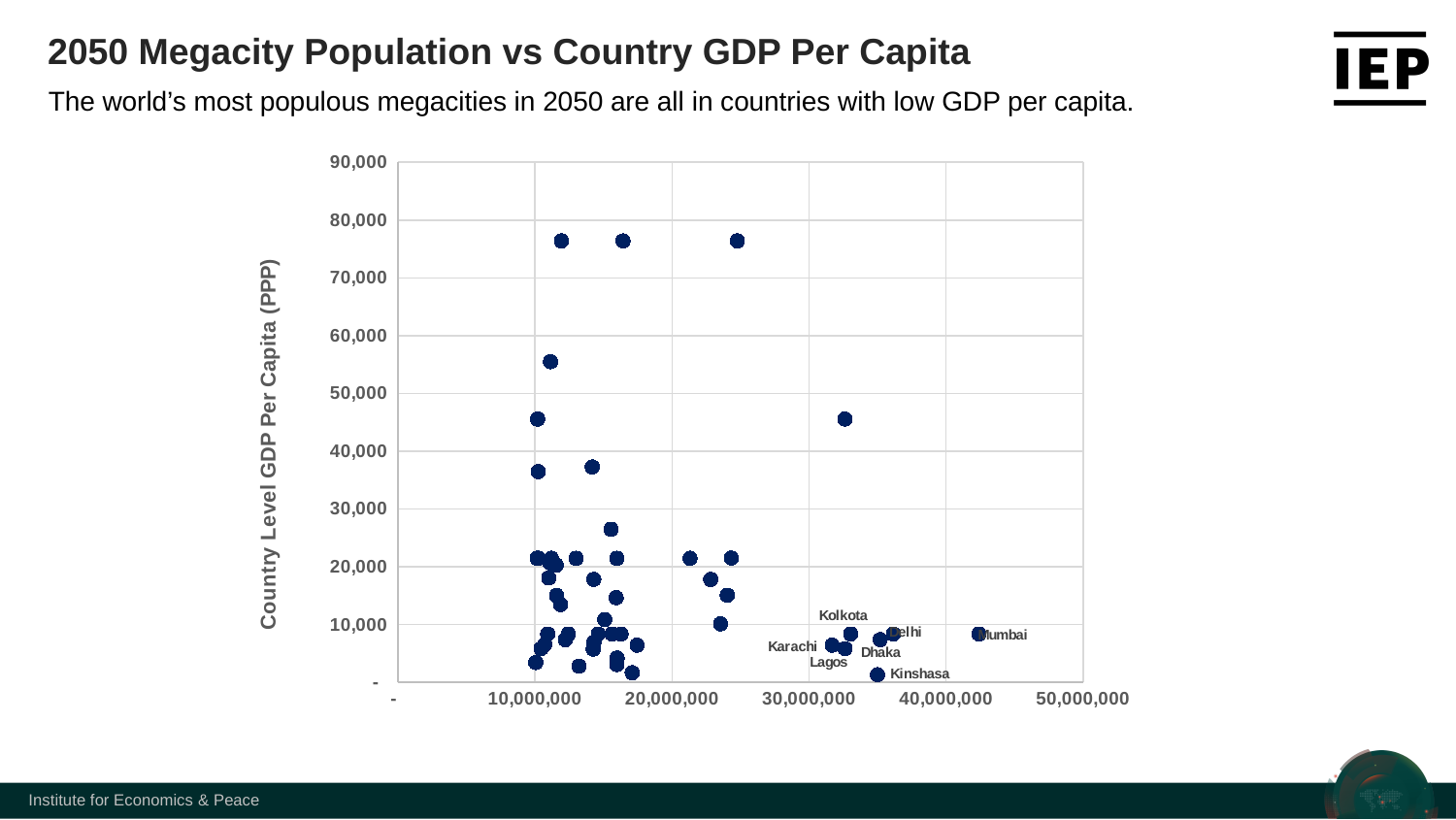
Is the GDP per capita value for Kinshasa greater or less than 10,000? less Is the population value for Delhi greater or less than 30,000,000? greater What is the label of the vertical axis? Country Level GDP Per Capita (PPP) What kind of chart is shown on the slide? scatter chart Which labelled city has the lowest GDP per capita? Kinshasa Which has the larger population, Mumbai or Karachi? Mumbai Is the GDP per capita value for Mumbai greater or less than 20,000? less Which labelled city has the largest population? Mumbai What is the title of the chart on the slide? 2050 Megacity Population vs Country GDP Per Capita How many points on the chart are labelled with a city name? 7